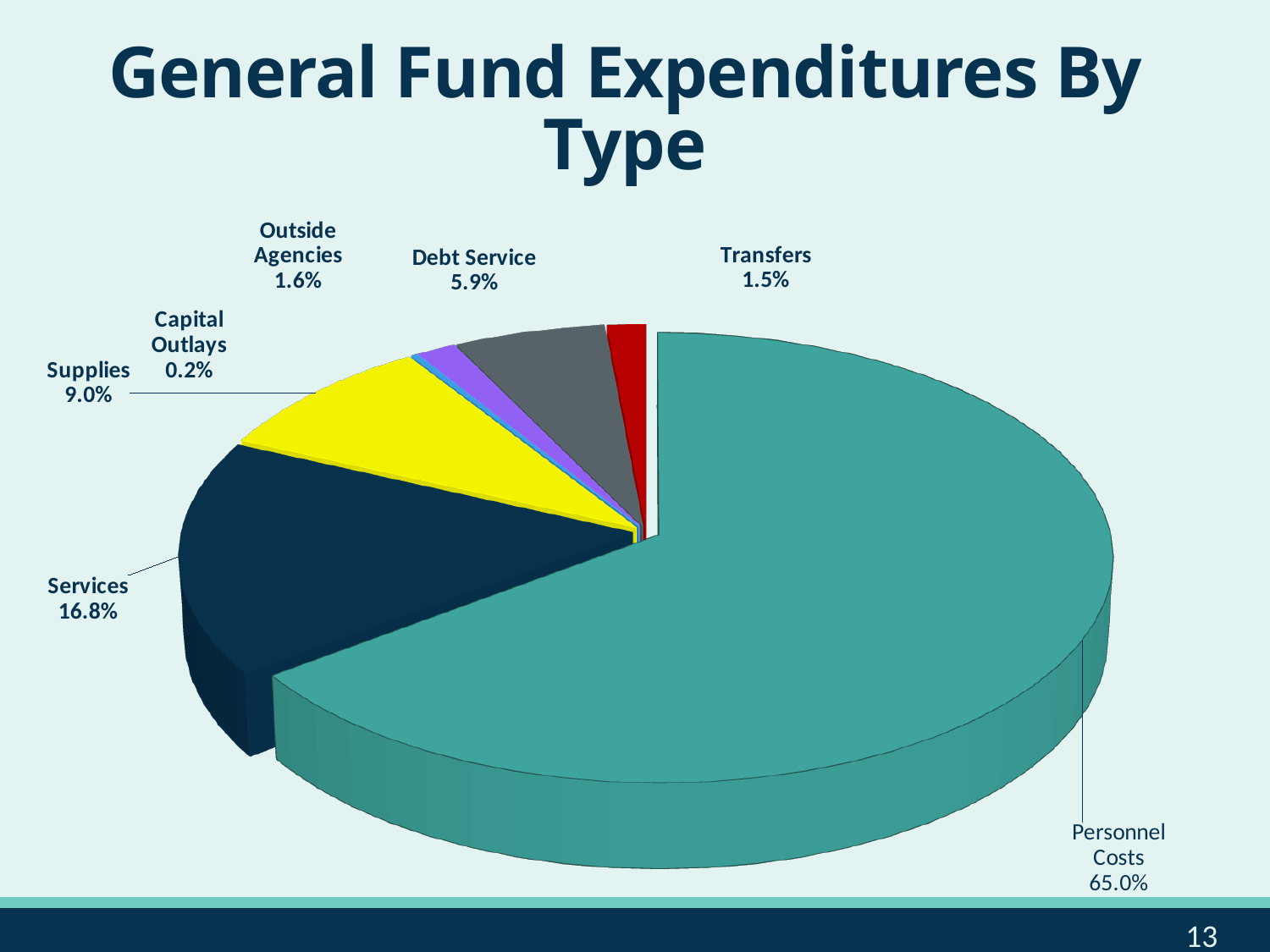
What is the title of the chart? General Fund Expenditures By Type What kind of chart is shown on the slide? Pie chart What is the difference in percentage points between Services and Supplies? 7.8 What share of General Fund expenditures is Personnel Costs? 65.0% How many expenditure types are shown in the pie chart? 7 What is the value for Capital Outlays? 0.2% Which is larger, Outside Agencies or Transfers? Outside Agencies Which expenditure type has the smallest share of the pie? Capital Outlays What is the value shown for Supplies? 9.0% Which expenditure type has the largest share of the pie? Personnel Costs What percentage is shown for Debt Service? 5.9% What percentage of the pie is Services? 16.8%